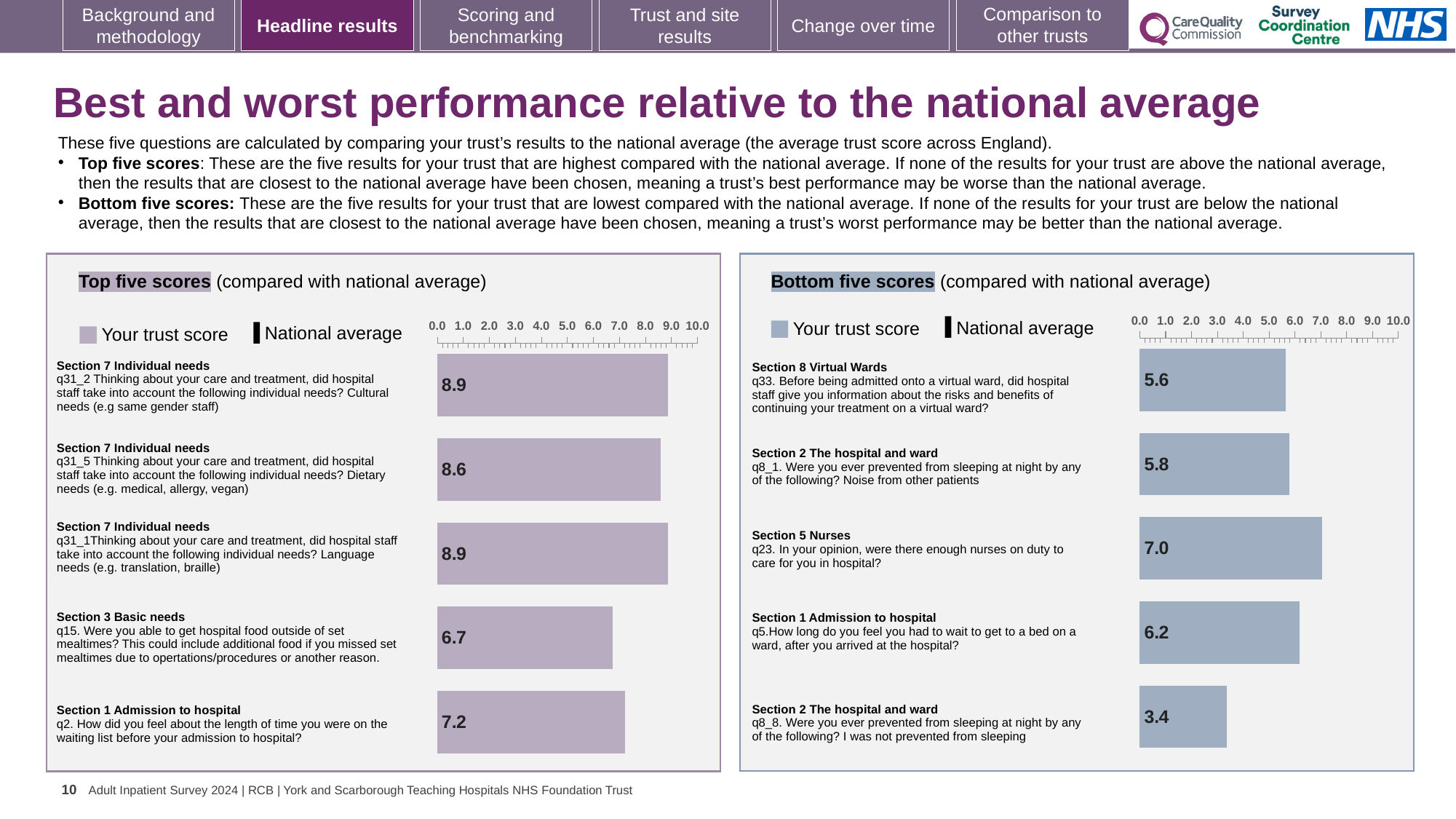
In the 'Top five scores' chart, what is the trust score for q31_2 (Cultural needs)? 8.9 In the 'Bottom five scores' chart, which question has the lowest trust score? q8_8 (I was not prevented from sleeping) In the 'Top five scores' chart, which question has the lowest trust score? q15 (hospital food outside of set mealtimes) How many questions are shown in the 'Top five scores' chart? 5 In the 'Bottom five scores' chart, which has the larger trust score: q33 (virtual ward) or q5 (wait for a bed)? q5 (wait for a bed) In the 'Top five scores' chart, what is the difference between the trust scores for q31_5 (Dietary needs) and q2 (waiting list)? 1.4 In the 'Bottom five scores' chart, what is the trust score for q23 (enough nurses on duty)? 7.0 What type of chart is used for the 'Bottom five scores'? Bar chart In the 'Top five scores' chart, what is the trust score for q15 (hospital food outside of set mealtimes)? 6.7 In the 'Bottom five scores' chart, what is the difference between the trust scores for q23 and q8_8? 3.6 In the 'Bottom five scores' chart, which question has the highest trust score? q23 (enough nurses on duty) In the 'Bottom five scores' chart, what is the trust score for q8_8 (I was not prevented from sleeping)? 3.4